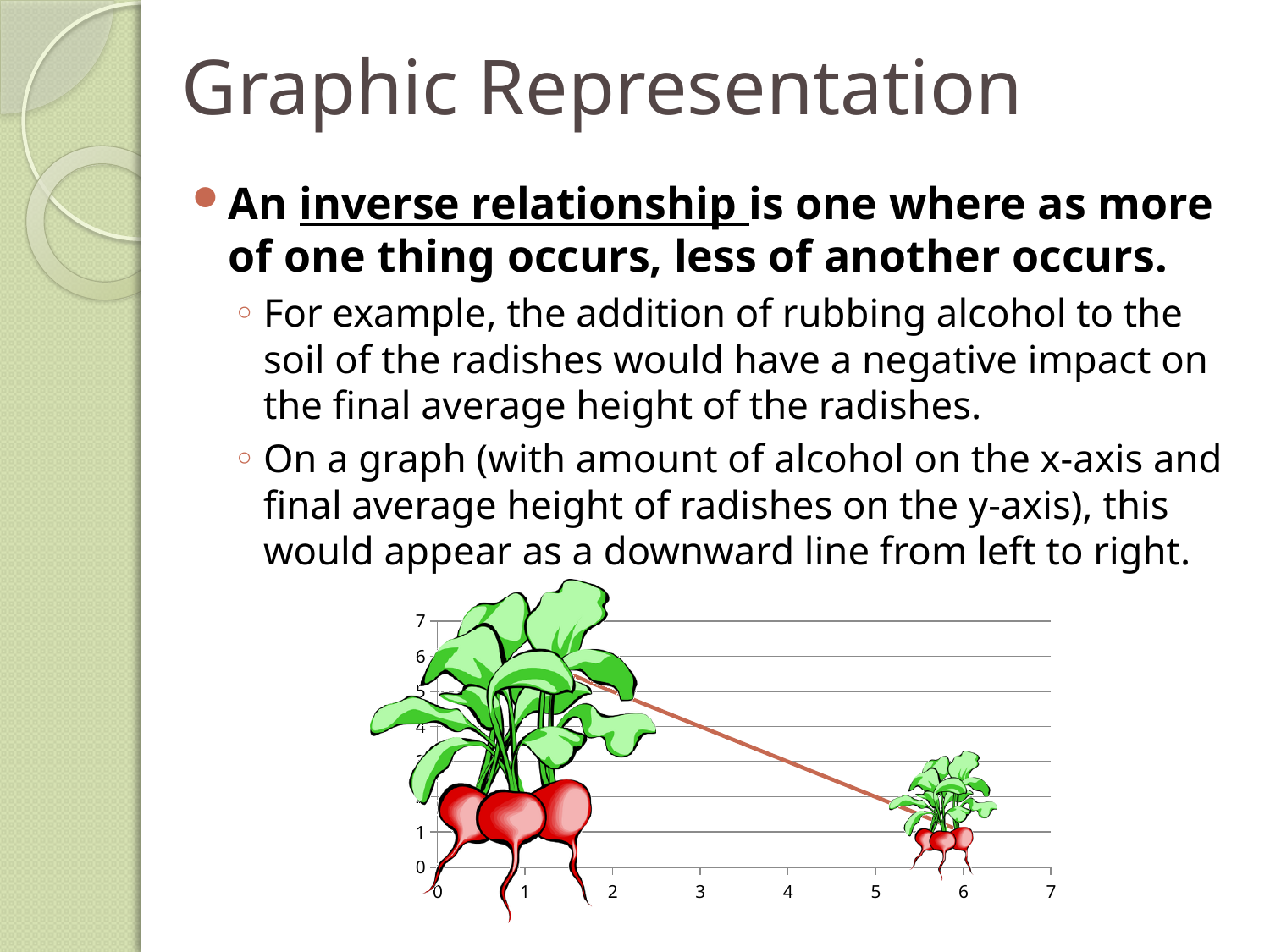
Is the value of the line at x = 6 greater or less than 2? less What kind of chart is shown on the slide? line chart What is the highest value labelled on the y axis of the chart? 7 Do the values on the chart rise or fall from left to right along the x axis? fall Is the value of the line at x = 6 greater or less than 4? less Is the value of the line at x = 2 greater or less than 6? less What is the highest value labelled on the x axis of the chart? 7 How many lines (series) are plotted on the chart? 1 Is the line's value higher at x = 2 or at x = 6? x = 2